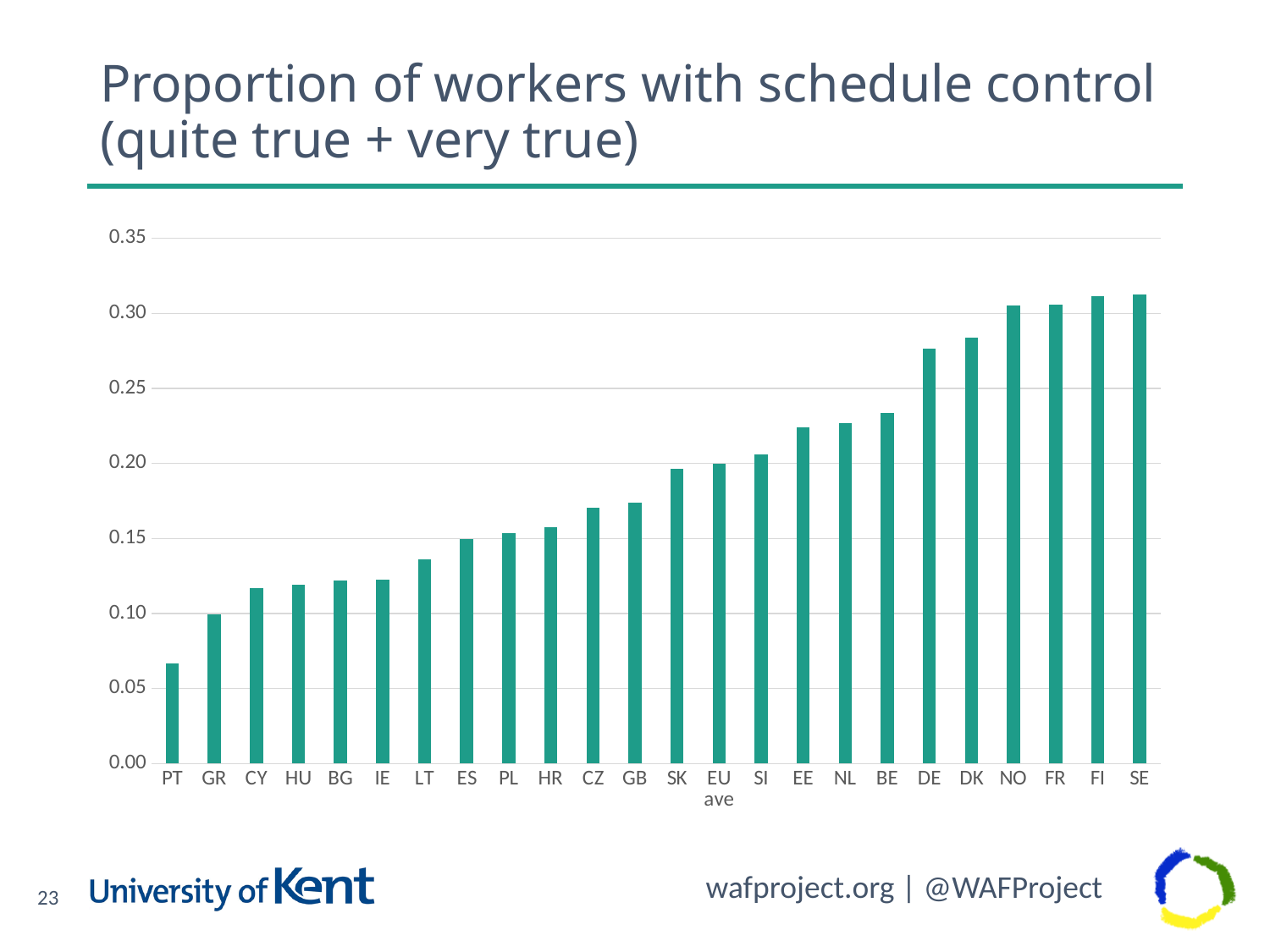
Is the value for DE greater or less than 0.30? less Is the value for SE greater or less than 0.30? greater Do the values generally rise or fall moving from left to right along the x axis? rise Is the value for LT greater or less than 0.15? less What is the title of the chart on the slide? Proportion of workers with schedule control (quite true + very true) How many categories are shown on the x axis of the chart? 24 Which has a higher value, DE or GB? DE What kind of chart is shown on the slide? bar chart Which category has the lowest proportion of workers with schedule control? PT